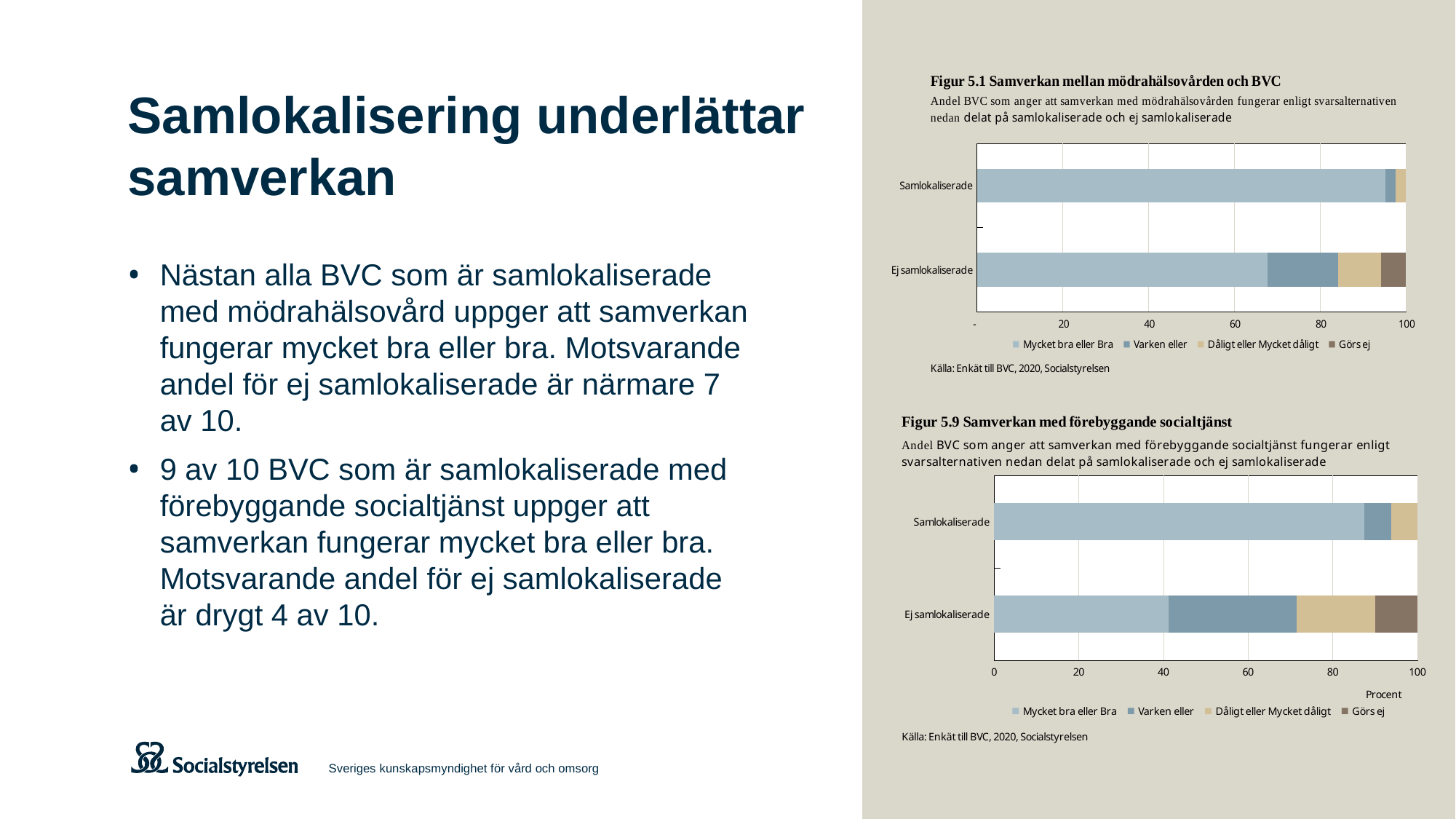
What kind of chart is Figur 5.1 Samverkan mellan mödrahälsovården och BVC? Stacked bar chart In Figur 5.1 Samverkan mellan mödrahälsovården och BVC, is the 'Mycket bra eller Bra' value for Samlokaliserade greater or less than 80? greater In Figur 5.1 Samverkan mellan mödrahälsovården och BVC, is the 'Mycket bra eller Bra' value for Ej samlokaliserade greater or less than 60? greater In Figur 5.9 Samverkan med förebyggande socialtjänst, is the 'Mycket bra eller Bra' value for Ej samlokaliserade greater or less than 60? less What is the x-axis unit label shown in Figur 5.9 Samverkan med förebyggande socialtjänst? Procent In Figur 5.9 Samverkan med förebyggande socialtjänst, which category has the larger 'Görs ej' share, Samlokaliserade or Ej samlokaliserade? Ej samlokaliserade What source is cited below Figur 5.1 Samverkan mellan mödrahälsovården och BVC? Källa: Enkät till BVC, 2020, Socialstyrelsen How many categories are shown on the y axis of Figur 5.1 Samverkan mellan mödrahälsovården och BVC? 2 How many series does the legend list in Figur 5.9 Samverkan med förebyggande socialtjänst? 4 In Figur 5.1 Samverkan mellan mödrahälsovården och BVC, which category has the larger 'Mycket bra eller Bra' share, Samlokaliserade or Ej samlokaliserade? Samlokaliserade